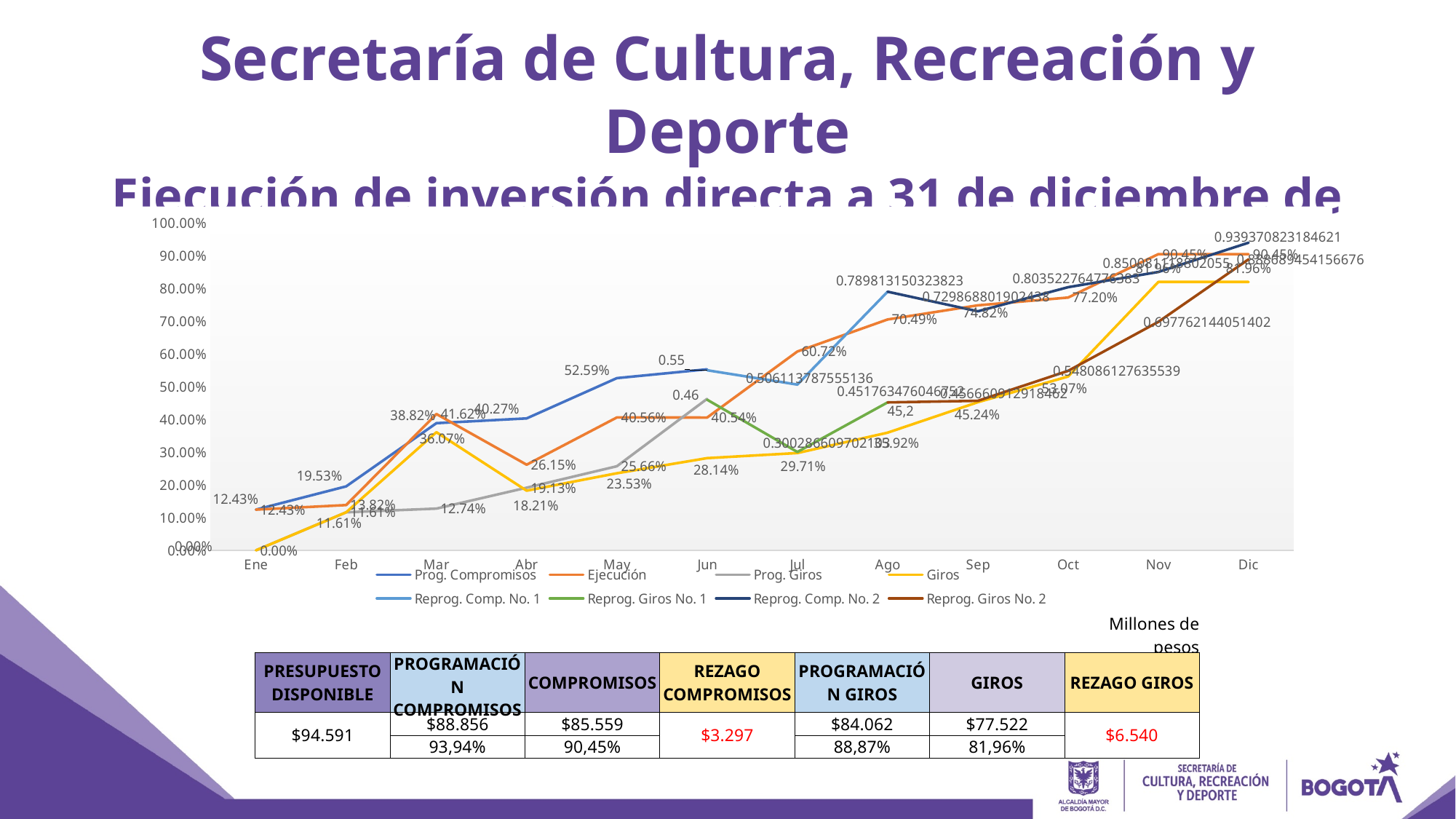
What is the value of the Giros series in Sep? 45.24% Which is larger in Jul, the Ejecución value or the Giros value? Ejecución What is the value of the Ejecución series in Abr? 26.15% What is the value of the Prog. Compromisos series in Feb? 19.53% What is the value of the Ejecución series in Jul? 60.72% What kind of chart is shown on the slide? line chart What is the value of the Prog. Compromisos series in May? 52.59% How many series does the chart legend list? 8 In which month is the Giros series at its lowest? Ene How many months are shown along the x axis of the chart? 12 In which month is the Ejecución series at its highest? Nov and Dic (tied at 90.45%) What is the value of the Ejecución series in Dic? 90.45%